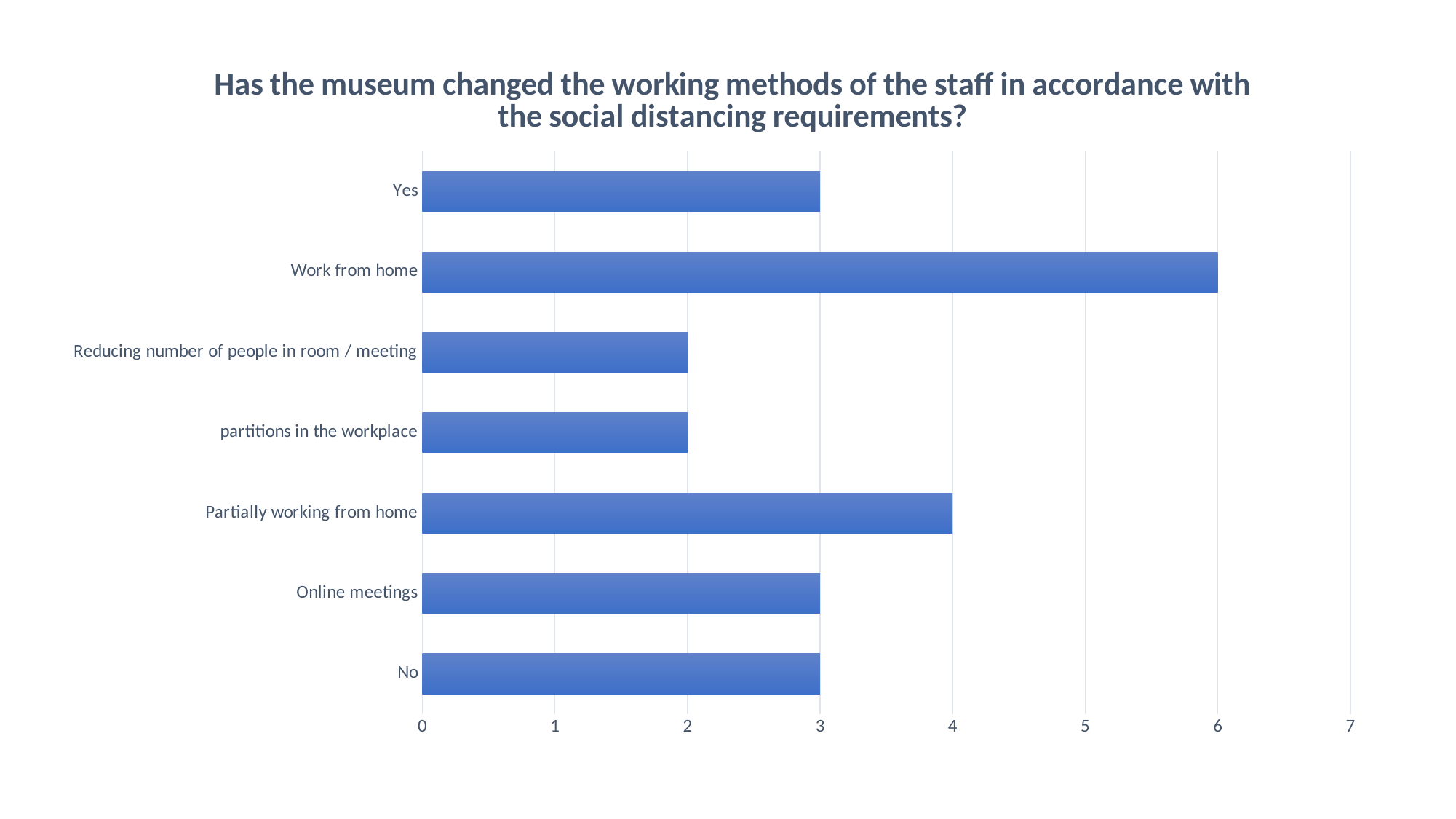
What is the value for "Work from home"? 6 Which category has the highest value? Work from home What kind of chart is shown on the slide? Bar chart How many categories are shown on the chart? 7 What is the value for "Partially working from home"? 4 What is the difference between the values for "Work from home" and "Partially working from home"? 2 What is the value for "partitions in the workplace"? 2 What is the value for "Online meetings"? 3 What is the highest value shown on the horizontal axis? 7 What is the title of the chart? Has the museum changed the working methods of the staff in accordance with the social distancing requirements? Which is larger, the value for "Yes" or the value for "Reducing number of people in room / meeting"? Yes Is the value for "Work from home" greater or less than 5? greater